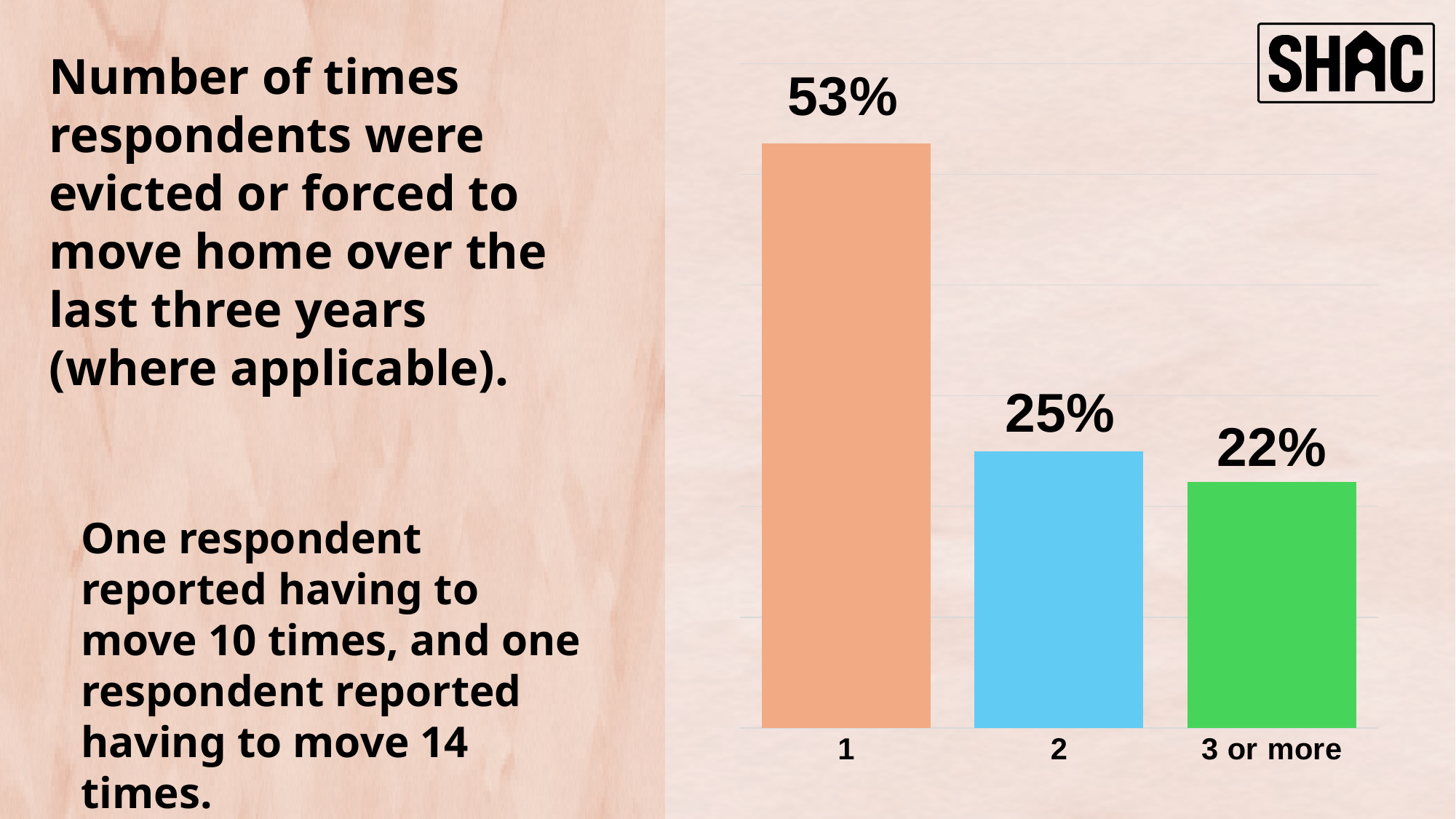
What percentage of respondents were evicted or forced to move home 2 times? 25% Which category has the highest percentage of respondents? 1 What colour is the bar for the '2' category? Blue What is the difference in percentage points between the '2' category and the '3 or more' category? 3 What is the difference in percentage points between the '1' category and the '2' category? 28 How many categories are shown on the chart? 3 What percentage of respondents were evicted or forced to move home 1 time? 53% What percentage of respondents were evicted or forced to move home 3 or more times? 22% Which category has the lowest percentage of respondents? 3 or more Do the values rise or fall from left to right along the x axis? Fall Which is larger, the value for '1' or the value for '3 or more'? 1 What kind of chart is shown on the slide? Bar chart